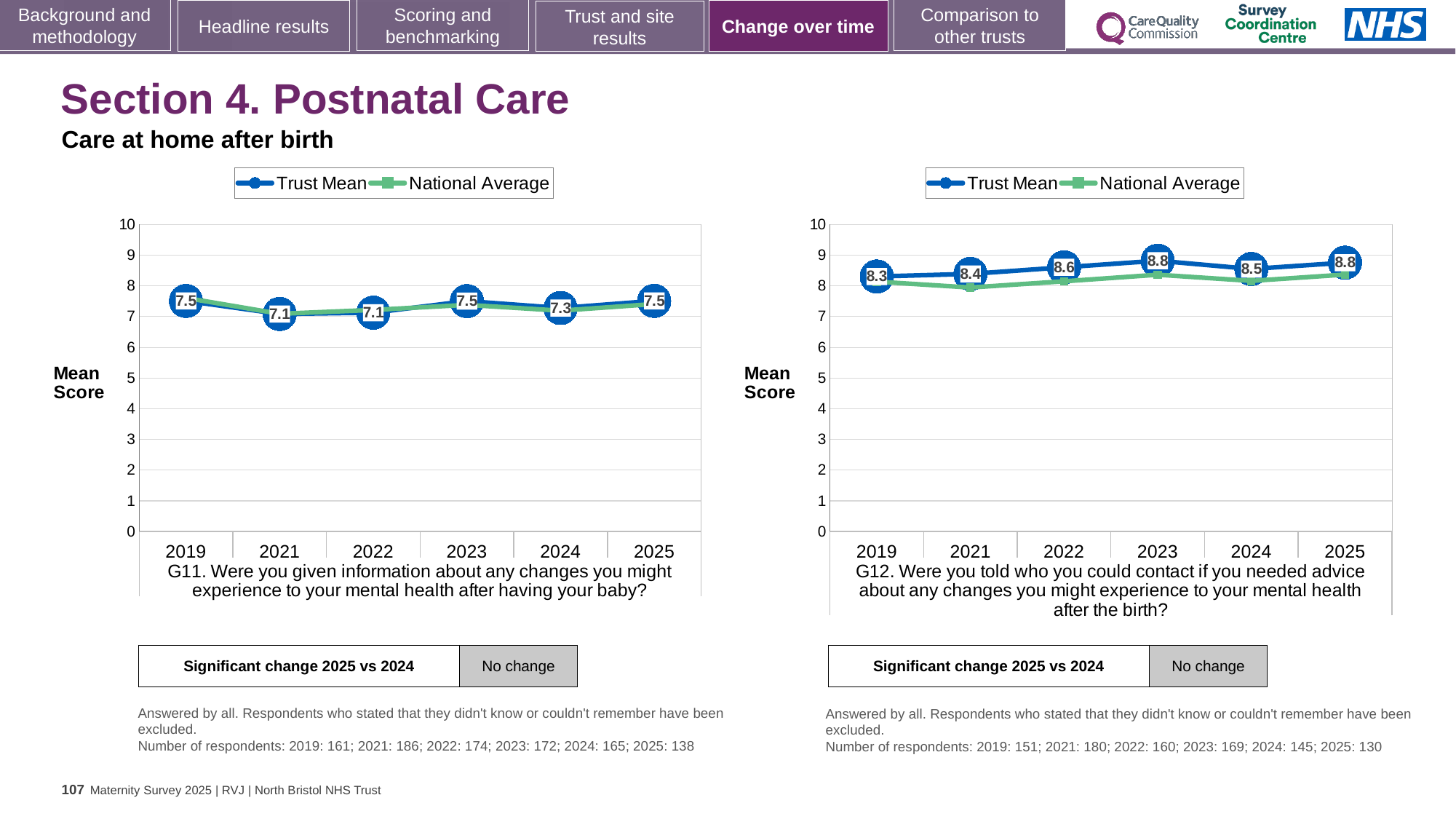
How many years are plotted on the x axis of the G11 chart on the left? 6 In the G12 chart on the right, is the Trust Mean score for 2021 larger or smaller than the score for 2023? smaller What type of chart is the G11 chart on the left? Line chart In the G12 chart on the right, what is the Trust Mean score for 2022? 8.6 In the G11 chart on the left, what is the Trust Mean score for 2024? 7.3 In the G12 chart on the right, which year has the lowest Trust Mean score? 2019 In the G11 chart on the left, what is the Trust Mean score for 2025? 7.5 How many series does the legend of the G12 chart on the right list? 2 In the G12 chart on the right, is the National Average value for 2023 greater or less than 8? greater In the G12 chart on the right, what is the difference between the Trust Mean scores for 2019 and 2023? 0.5 In the G11 chart on the left, what is the difference between the Trust Mean scores for 2023 and 2024? 0.2 In the G12 chart on the right, what is the Trust Mean score for 2024? 8.5